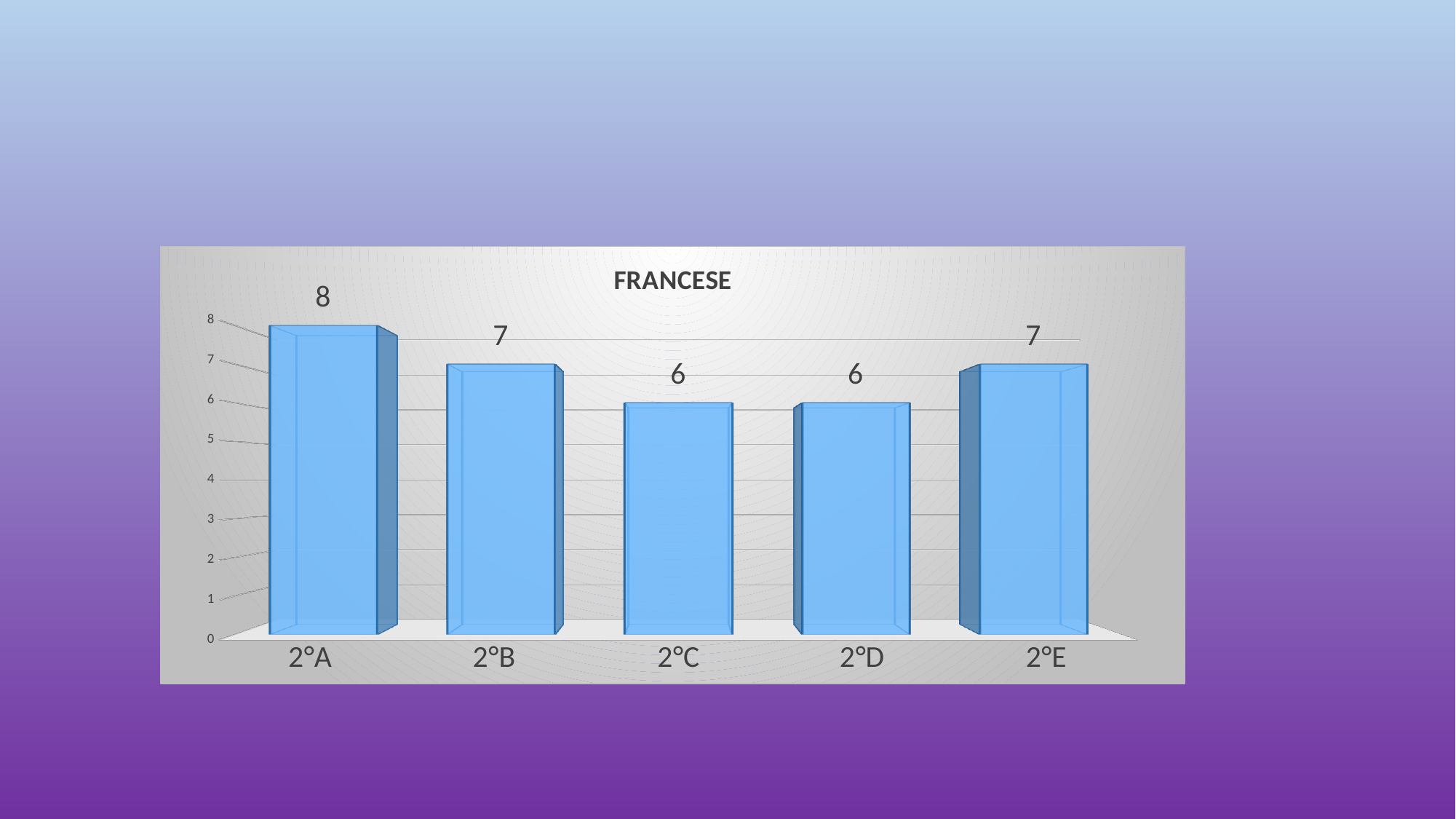
What is the difference between the values for 2°B and 2°C? 1 What is the difference between the values for 2°A and 2°D? 2 What is the title of the chart? FRANCESE How many categories are shown on the x axis? 5 Is the value for 2°A greater or less than 5? greater What kind of chart is shown? bar chart What is the value for 2°E? 7 Which is larger, the value for 2°B or the value for 2°D? 2°B Which category has the highest value? 2°A What is the value for 2°A? 8 What is the highest tick value shown on the vertical axis? 8 What is the value for 2°C? 6